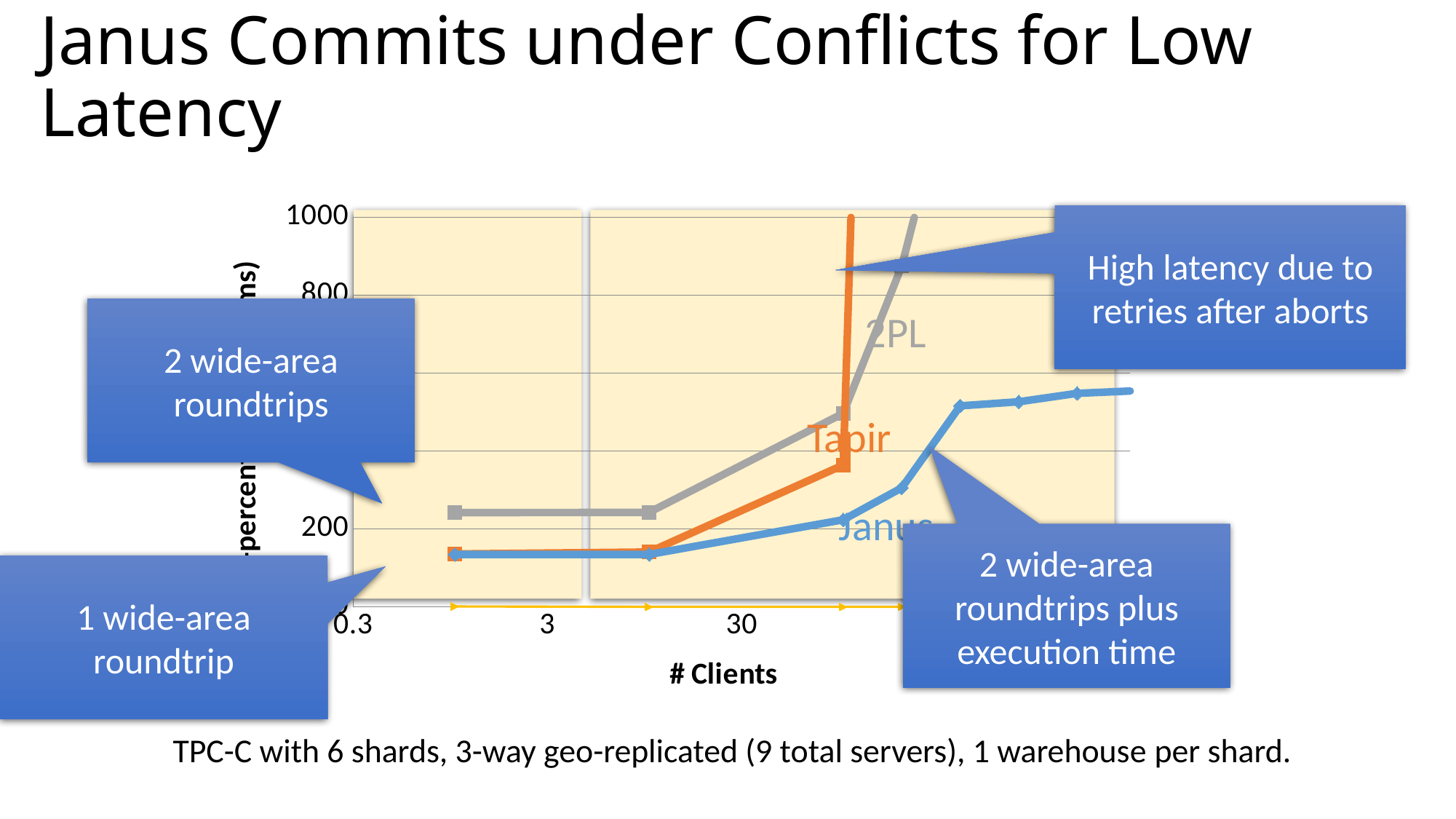
What is the label of the x axis of the chart? # Clients What kind of chart is shown on the slide? line chart How many series (lines) are plotted in the chart? 3 Which series has the lowest value at the highest number of clients shown? Janus Is the value for Janus at its rightmost point greater or less than 200? greater What are the names of the three series labelled on the chart? 2PL, Tapir, Janus Does the Janus line rise or fall as the number of clients increases? rise